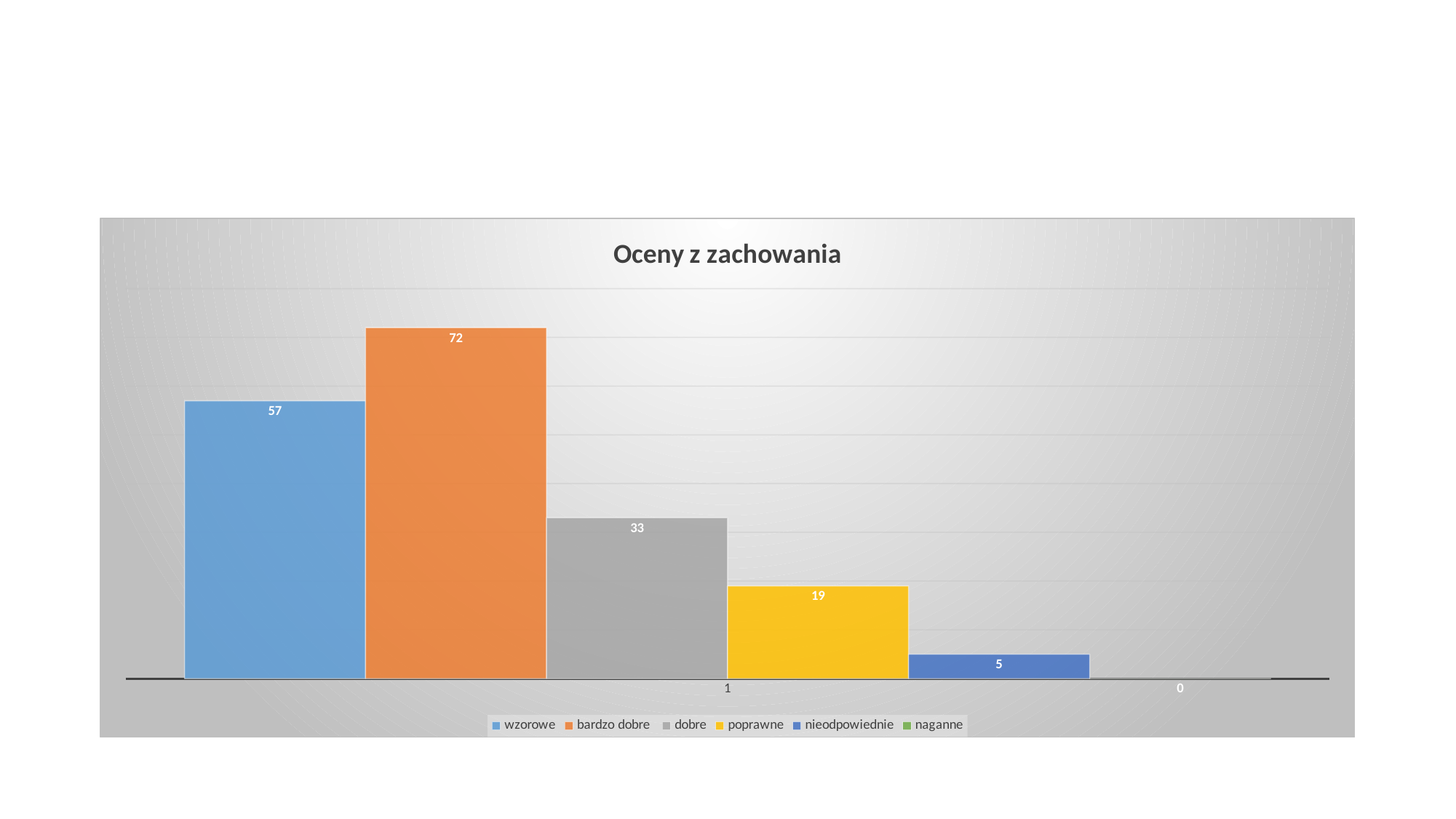
What is the value for poprawne? 19 Which is larger, the value for dobre or the value for poprawne? dobre What is the difference between the values for bardzo dobre and wzorowe? 15 How many series does the legend list? 6 Which series has the highest value? bardzo dobre What is the value for nieodpowiednie? 5 Which series has the lowest value? naganne What is the title of the chart? Oceny z zachowania What is the value for bardzo dobre? 72 What is the value for wzorowe? 57 What is the value for dobre? 33 What type of chart is shown on the slide? bar chart